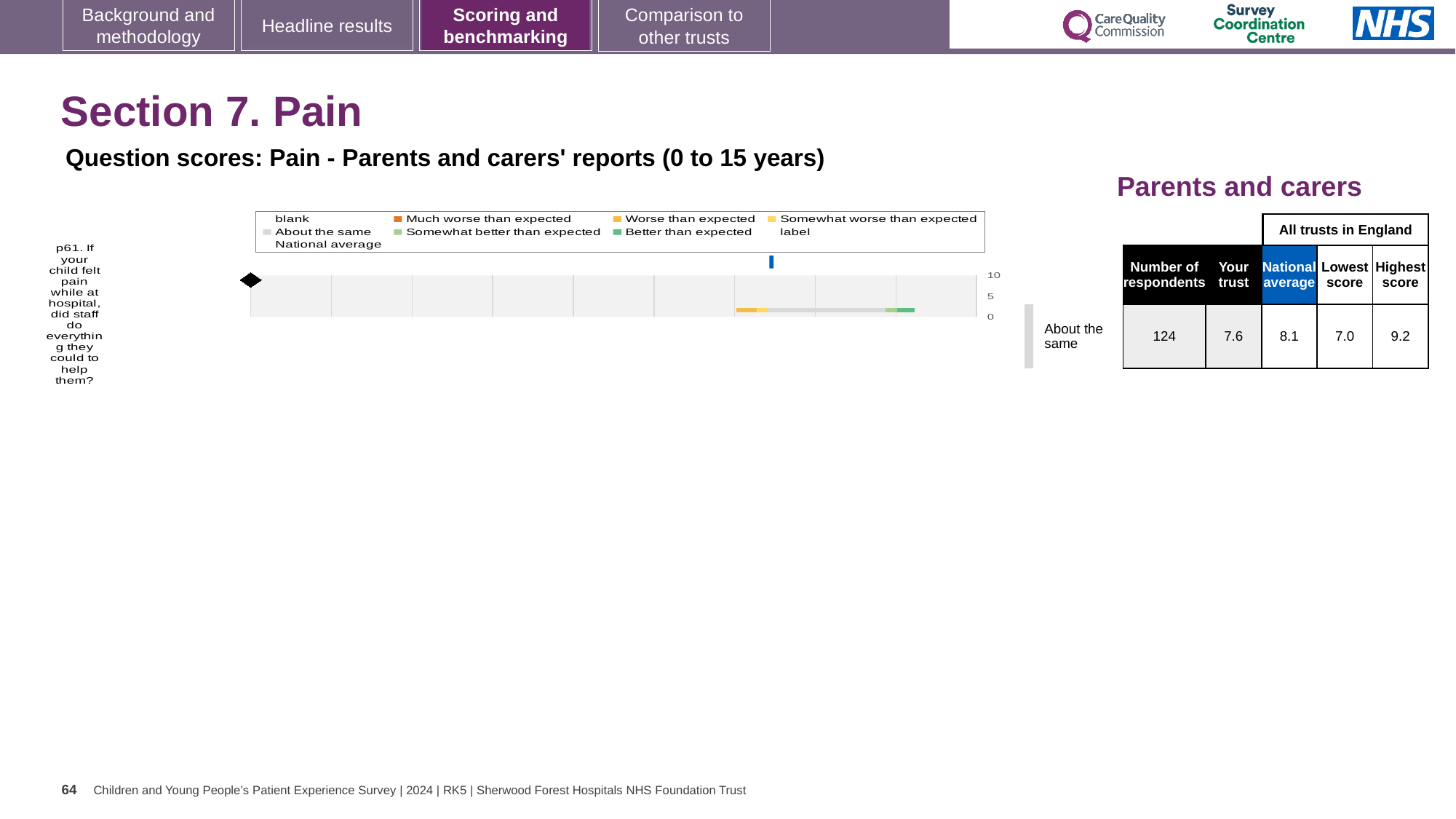
How many respondents answered the p61 question? 124 What is the highest value shown on the chart's axis? 10 What kind of chart is shown on the slide? bar chart Which is larger for the p61 question, the trust's score or the national average? National average What is the highest score among all trusts in England for the p61 question? 9.2 What is the difference between the national average and the trust's score for the p61 question? 0.5 How many question categories are plotted on the chart? 1 What is the 'Your trust' score for the p61 question in the table? 7.6 Is the trust's score for p61 greater or less than 5? greater Which question is plotted on the chart? p61. If your child felt pain while at hospital, did staff do everything they could to help them? What is the lowest score among all trusts in England for the p61 question? 7.0 What is the national average score for the p61 question in the table? 8.1